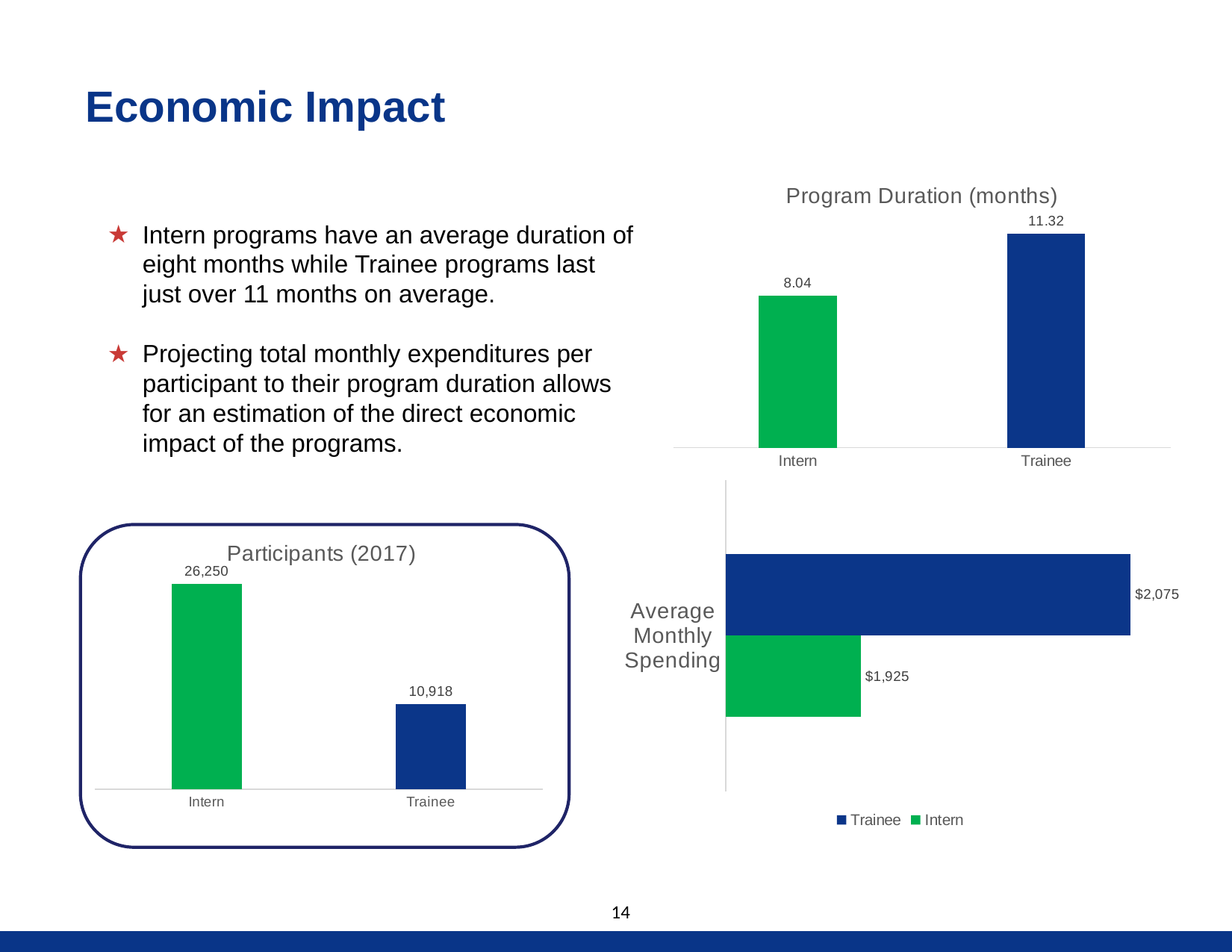
In the Average Monthly Spending chart, what is the value for Intern? $1,925 In the Participants (2017) chart, what is the difference between the Intern and Trainee values? 15,332 In the Participants (2017) chart, what is the value for Trainee? 10,918 In the Program Duration (months) chart, what is the value for Intern? 8.04 In the Program Duration (months) chart, what is the value for Trainee? 11.32 How many series does the legend of the Average Monthly Spending chart list? 2 In the Program Duration (months) chart, what is the difference between the Trainee and Intern values? 3.28 In the Average Monthly Spending chart, what is the value for Trainee? $2,075 In the Program Duration (months) chart, which category has the longest duration? Trainee In the Average Monthly Spending chart, which is larger, Trainee or Intern? Trainee In the Participants (2017) chart, which category has the lowest value? Trainee In the Participants (2017) chart, what is the value for Intern? 26,250